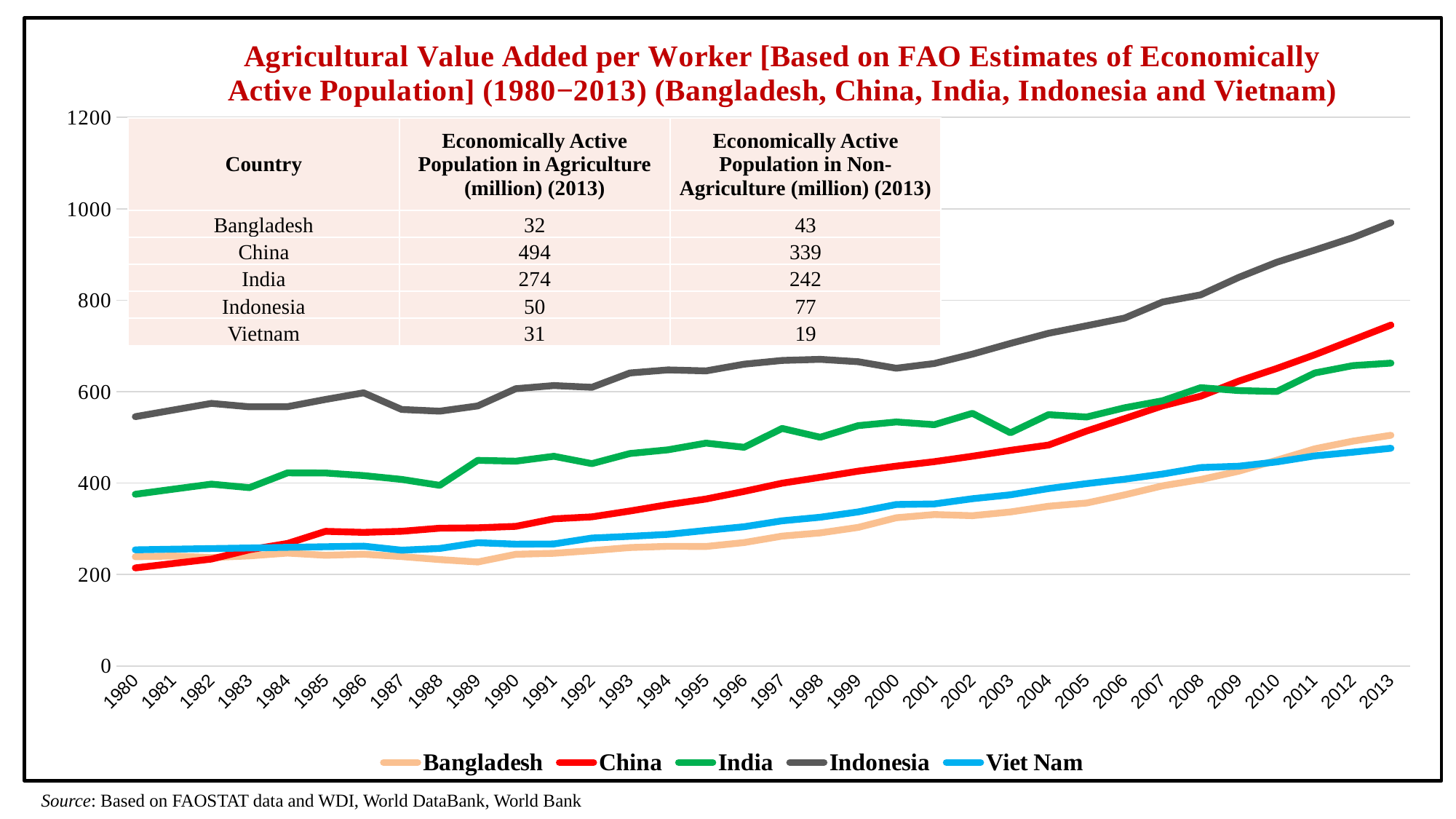
How many series does the legend list? 5 Which country has the highest agricultural value added per worker in 2013? Indonesia Is the value for China in 1980 greater or less than 400? less Is the value for India in 2013 greater or less than 600? greater Does the Indonesia line generally rise or fall from 1980 to 2013? rise Which country has the lowest agricultural value added per worker in 1980? China In 2013, which is larger, the value for China or the value for India? China Is the value for Viet Nam in 2013 greater or less than 600? less What kind of chart is shown on the slide? line chart Which colour is used for the China series in the legend? red How many years are plotted along the x axis? 34